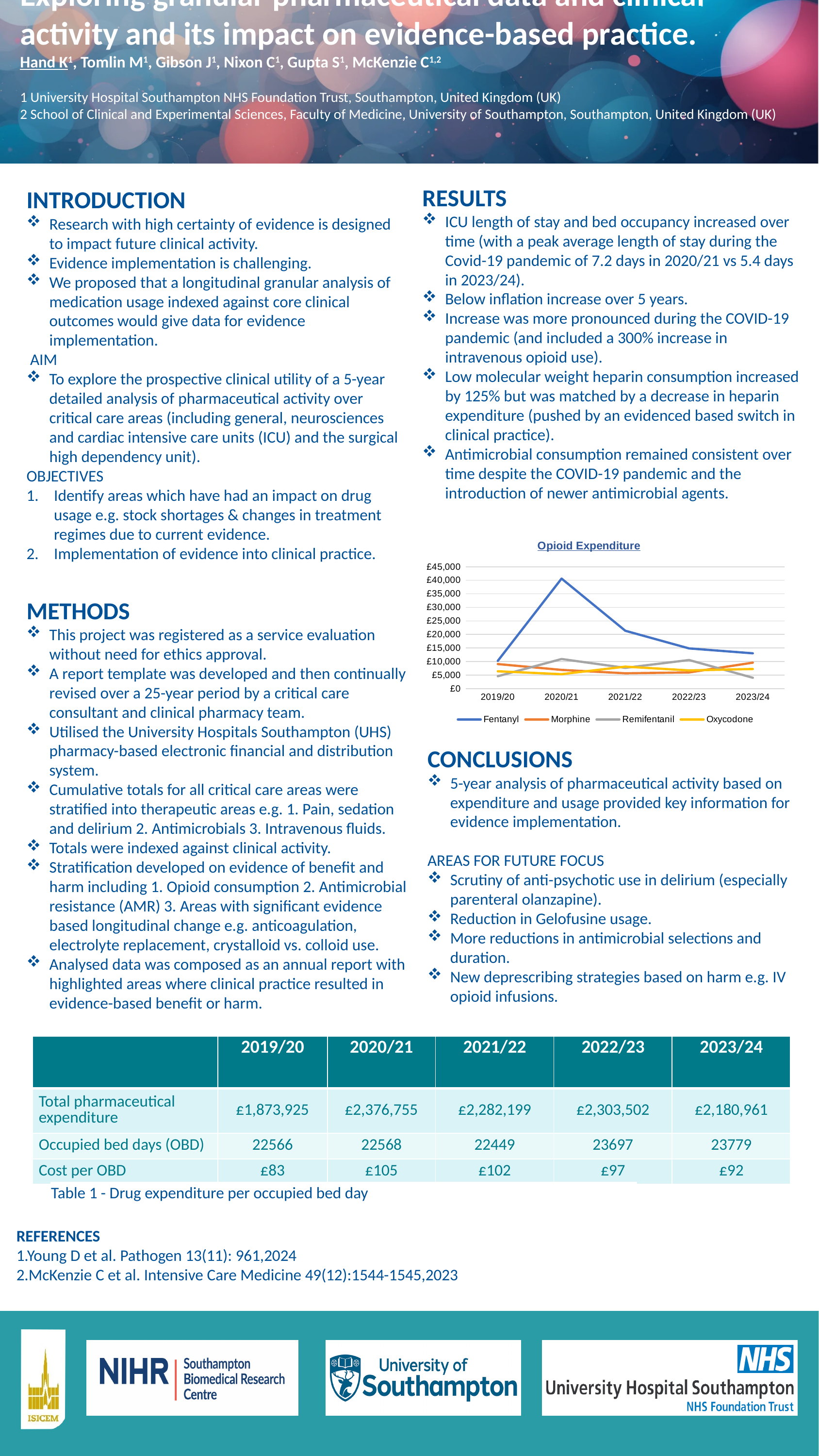
In the Opioid Expenditure chart, which series has the highest value in 2022/23? Fentanyl How many financial years are shown on the x axis of the Opioid Expenditure chart? 5 How many series does the legend of the Opioid Expenditure chart list? 4 In the Opioid Expenditure chart, does Fentanyl expenditure rise or fall from 2020/21 to 2023/24? fall In the Opioid Expenditure chart, which series has the lowest value in 2023/24? Remifentanil In the Opioid Expenditure chart, which is larger in 2020/21: Fentanyl or Morphine? Fentanyl In which year is Fentanyl expenditure highest in the Opioid Expenditure chart? 2020/21 In the Opioid Expenditure chart, is the Fentanyl value for 2020/21 greater or less than £35,000? greater In the Opioid Expenditure chart, is the Fentanyl value for 2019/20 greater or less than £15,000? less What colour is the Fentanyl line in the Opioid Expenditure chart? blue What type of chart is the Opioid Expenditure chart? line chart In the Opioid Expenditure chart, is the Fentanyl value for 2021/22 greater or less than £15,000? greater